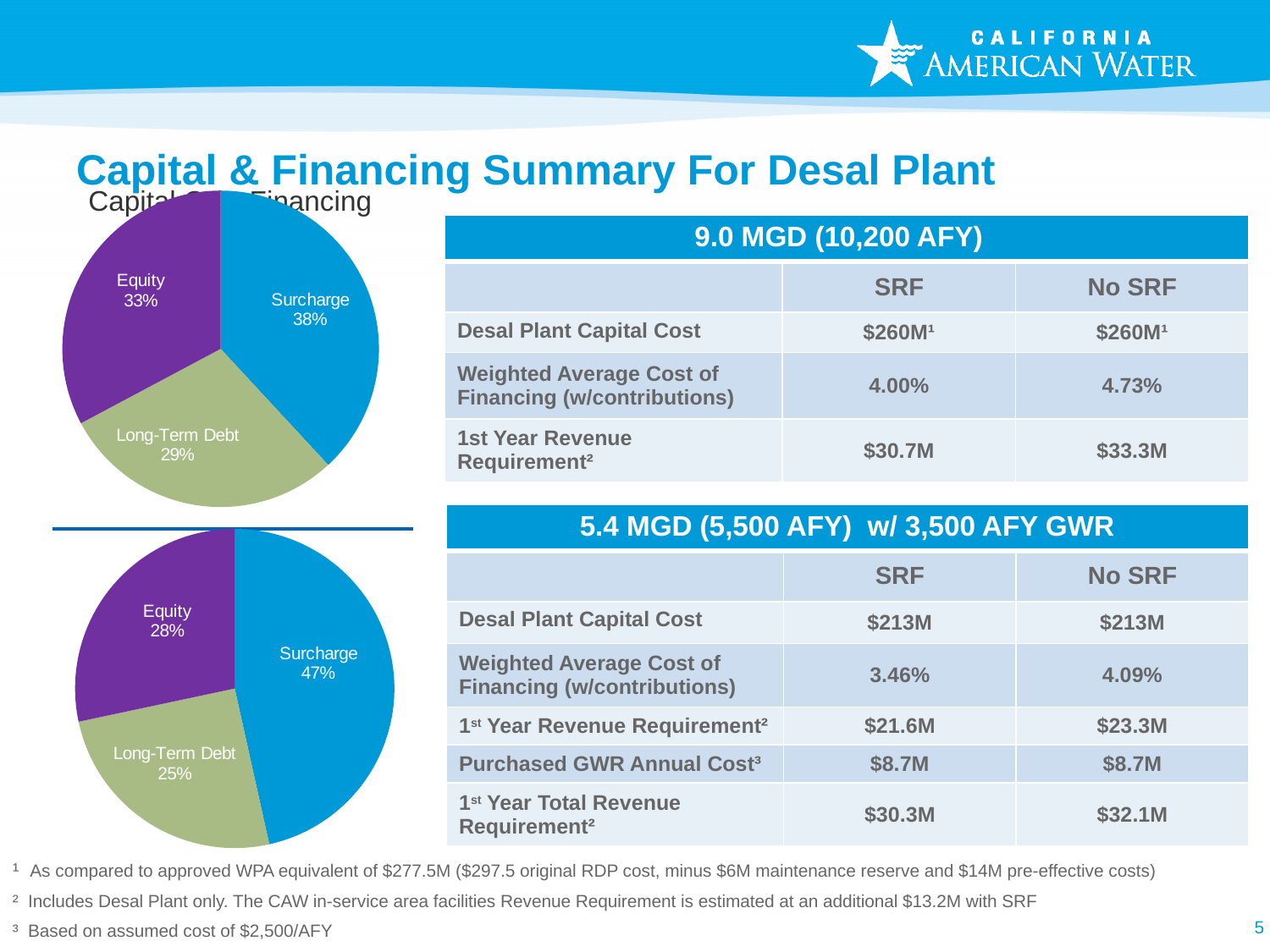
In the bottom pie chart, what share is Surcharge? 47% What type of chart is the top chart on the slide? Pie chart In the bottom pie chart, which is larger, Equity or Long-Term Debt? Equity In the bottom pie chart, which slice is the largest? Surcharge In the top pie chart, what share is Equity? 33% In the top pie chart, what share is Surcharge? 38% In the top pie chart, what share is Long-Term Debt? 29% How many slices does the bottom pie chart have? 3 In the top pie chart, which slice is the smallest? Long-Term Debt In the top pie chart, which slice is the largest? Surcharge In the bottom pie chart, what share is Long-Term Debt? 25% In the top pie chart, what is the difference between the Surcharge and Long-Term Debt shares? 9%